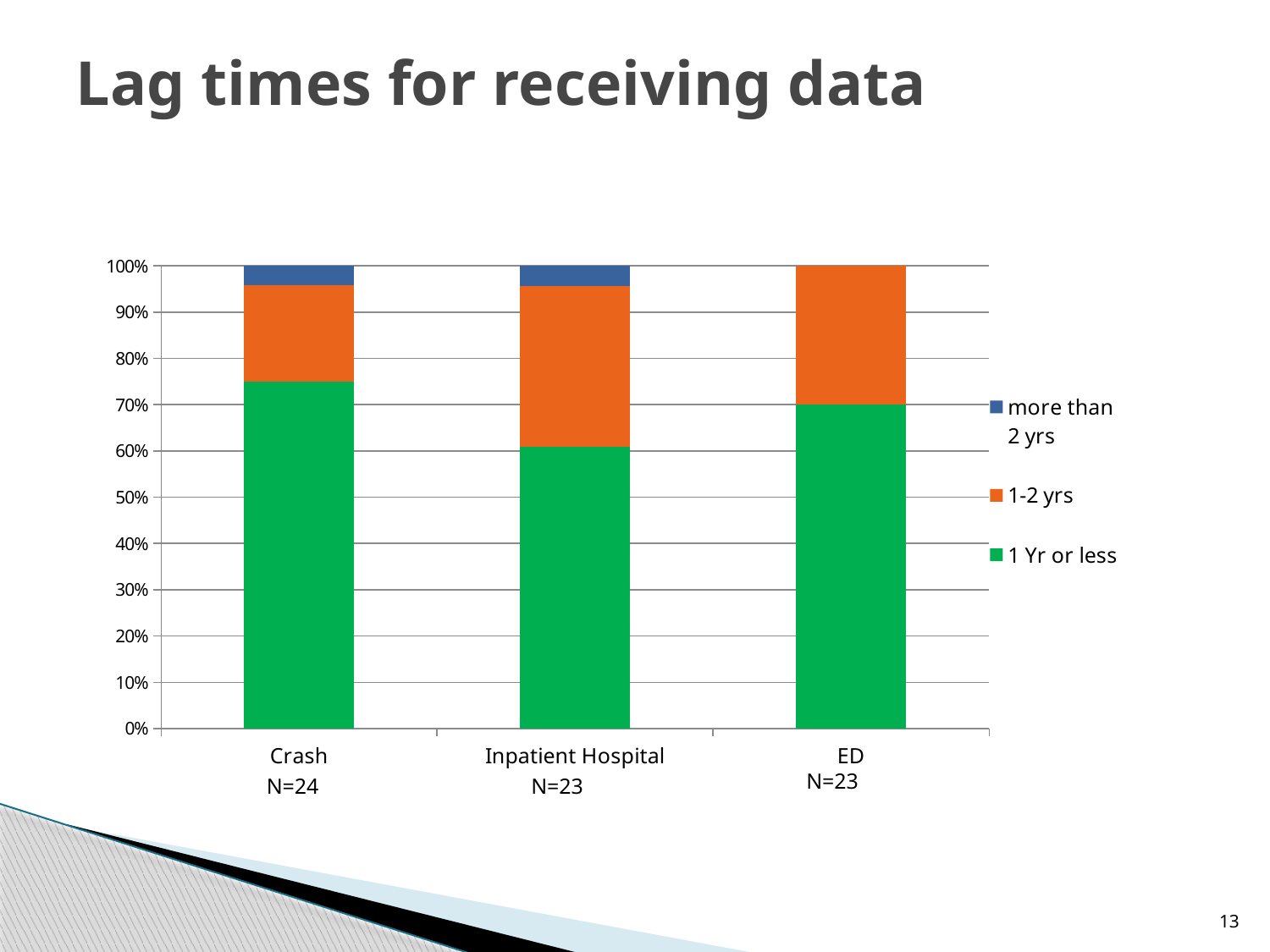
What kind of chart is shown on the slide? Stacked bar chart Which category has the highest share for '1 Yr or less'? Crash Which category has no 'more than 2 yrs' segment? ED What is the total of the stacked bar for Crash? 100% Which is larger, the '1-2 yrs' segment for Crash or for Inpatient Hospital? Inpatient Hospital What is the title of the slide containing the chart? Lag times for receiving data Is the '1 Yr or less' value for Inpatient Hospital greater or less than 70%? less Which category has the lowest share for '1 Yr or less'? Inpatient Hospital How many series does the legend list? 3 How many categories are shown on the x axis of the chart? 3 What is the sample size (N) shown for the Crash category? N=24 Is the '1 Yr or less' value for Crash greater or less than 70%? greater